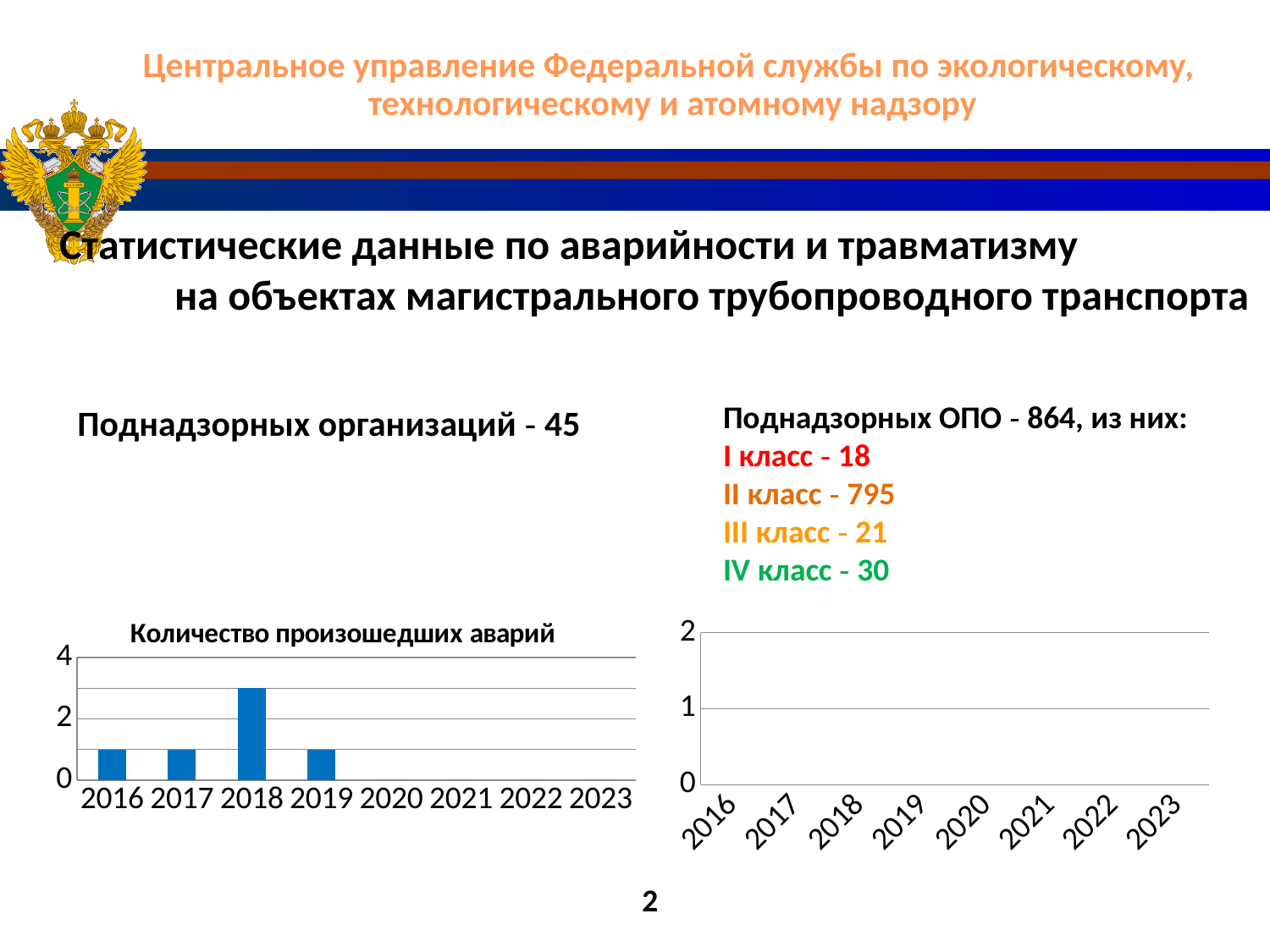
What is the title of the chart on the left side of the slide? Количество произошедших аварий What kind of chart is the chart titled 'Количество произошедших аварий'? bar chart In the chart titled 'Количество произошедших аварий', is the value for 2018 greater or less than 2? greater In the chart titled 'Количество произошедших аварий', what is the highest value shown on the vertical axis? 4 In the chart titled 'Количество произошедших аварий', is the value for 2016 greater or less than 2? less In the chart on the right side of the slide, how many years are listed on the x axis? 8 In the chart titled 'Количество произошедших аварий', which year has the highest value? 2018 In the chart titled 'Количество произошедших аварий', is the value for 2019 greater or less than 2? less In the chart titled 'Количество произошедших аварий', which is larger, the value for 2018 or the value for 2017? 2018 In the chart on the right side of the slide, what is the highest value shown on the vertical axis? 2 In the chart titled 'Количество произошедших аварий', how many years are shown on the x axis? 8